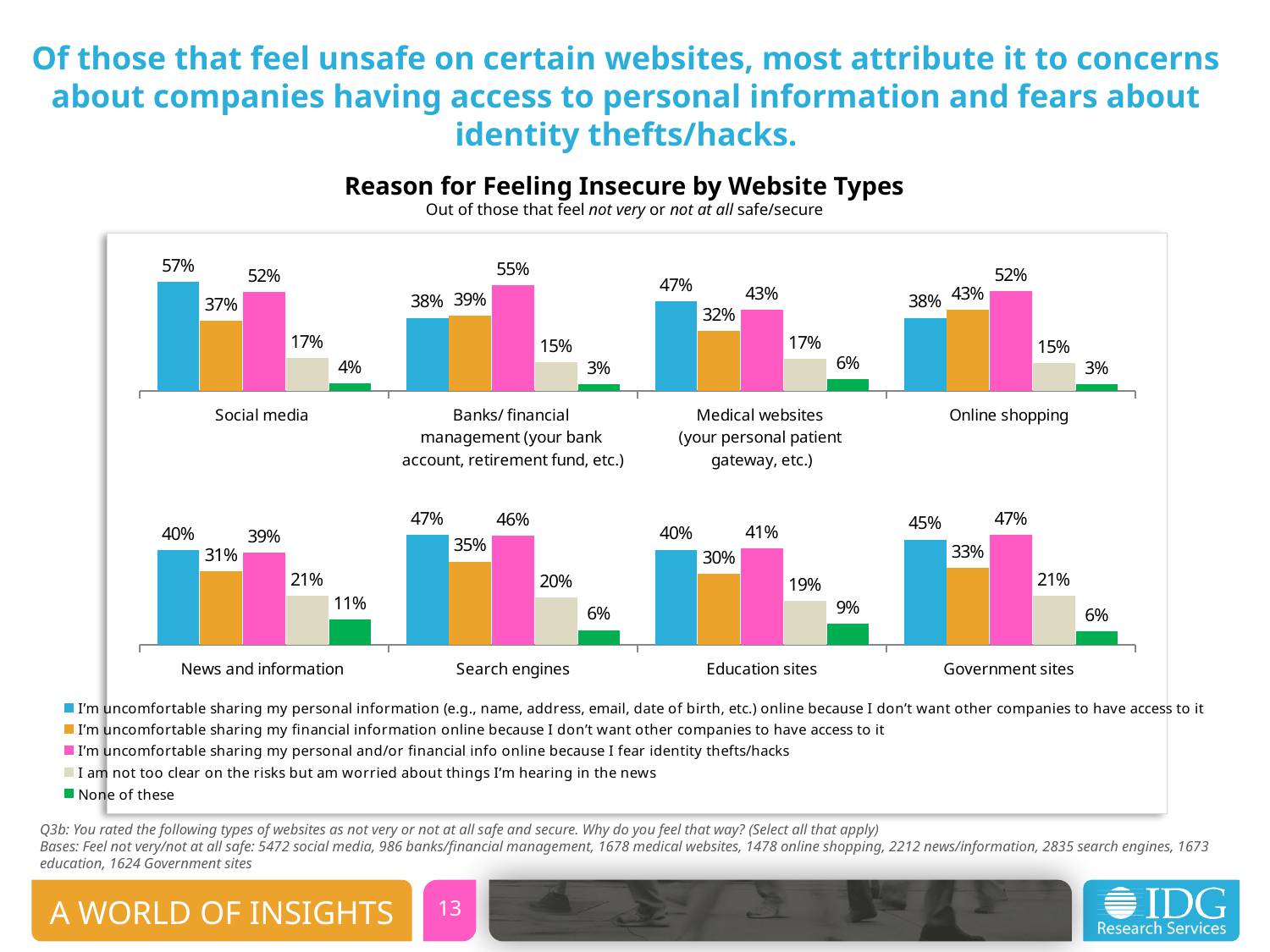
What percentage of respondents who feel unsafe on social media say they are uncomfortable sharing personal information because they don't want other companies to have access to it? 57% What is the title of the chart? Reason for Feeling Insecure by Website Types Which website type has the lowest 'None of these' value? Banks/ financial management and Online shopping (3%) What type of chart is shown on the slide? Bar chart For online shopping, which is larger: the share uncomfortable sharing financial information or the share uncomfortable sharing personal information? Financial information (43%) What percentage of those who feel unsafe on government sites say they are not too clear on the risks but are worried about things they're hearing in the news? 21% How many series does the legend list? 5 What is the 'None of these' value for news and information websites? 11% What is the difference between the identity theft/hacks value for social media and for medical websites? 9 percentage points How many website types are shown in the chart? 8 Which website type has the highest value for 'I'm uncomfortable sharing my personal information ... because I don't want other companies to have access to it'? Social media For banks/financial management websites, what percentage say they fear identity thefts/hacks? 55%